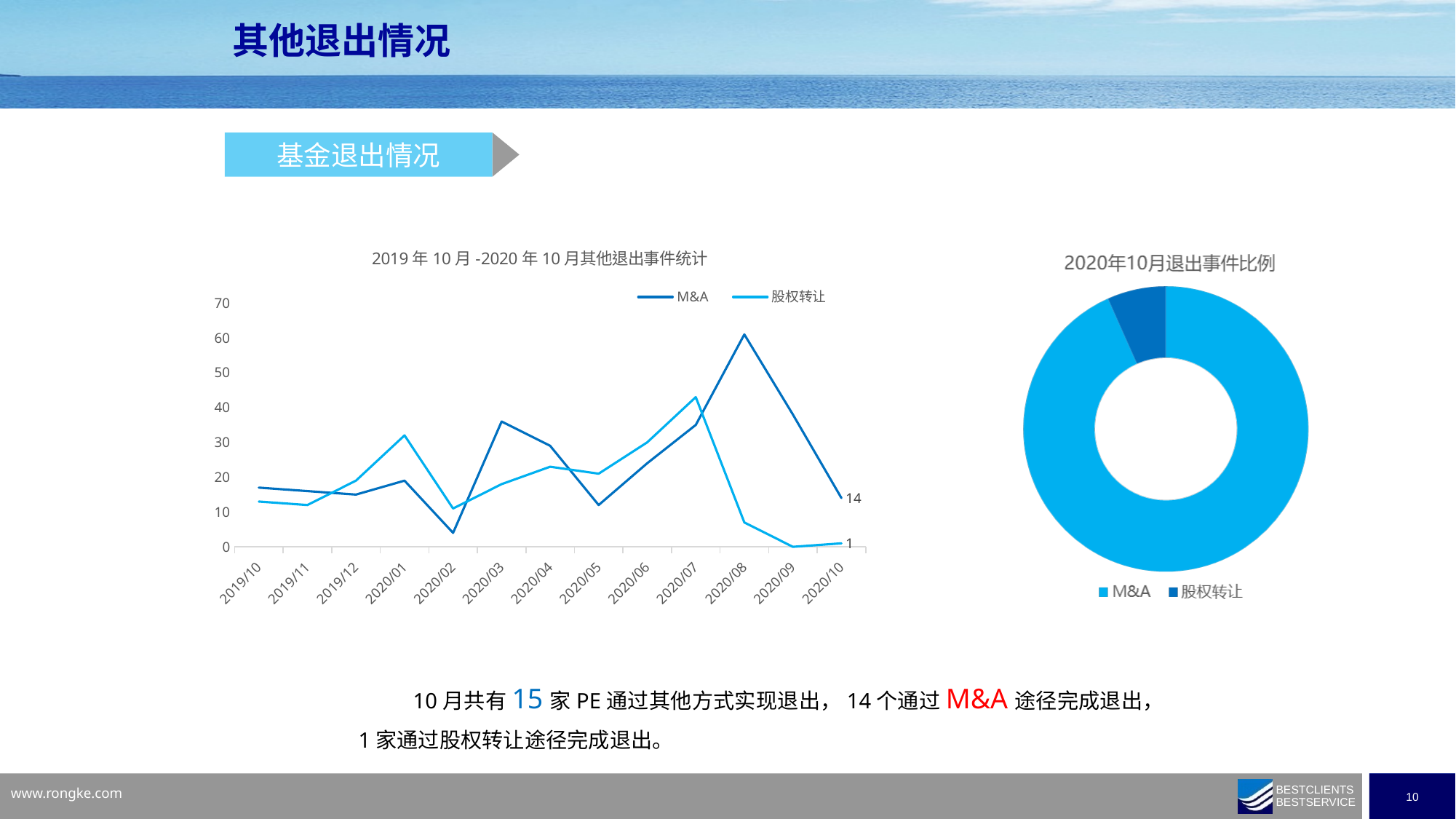
In the line chart on the left, in which month does the 股权转让 series reach its highest value? 2020/07 In the line chart on the left, in which month does the M&A series reach its highest value? 2020/08 In the line chart on the left, what is the 股权转让 value for 2020/10? 1 In the line chart on the left, is the M&A value for 2020/08 greater or less than 50? greater In the line chart on the left, how many series does the legend list? 2 What kind of chart is the chart titled 2020年10月退出事件比例? Doughnut (pie) chart In the line chart on the left, in which month does the M&A series reach its lowest value? 2020/02 In the line chart on the left, how many months are shown on the x axis? 13 In the chart titled 2020年10月退出事件比例, which category has the larger share, M&A or 股权转让? M&A In the line chart on the left, is the 股权转让 value for 2020/07 greater or less than 40? greater In the line chart on the left, is the M&A value for 2020/02 greater or less than 10? less In the line chart titled 2019 年 10 月 -2020 年 10 月其他退出事件统计, what is the M&A value for 2020/10? 14